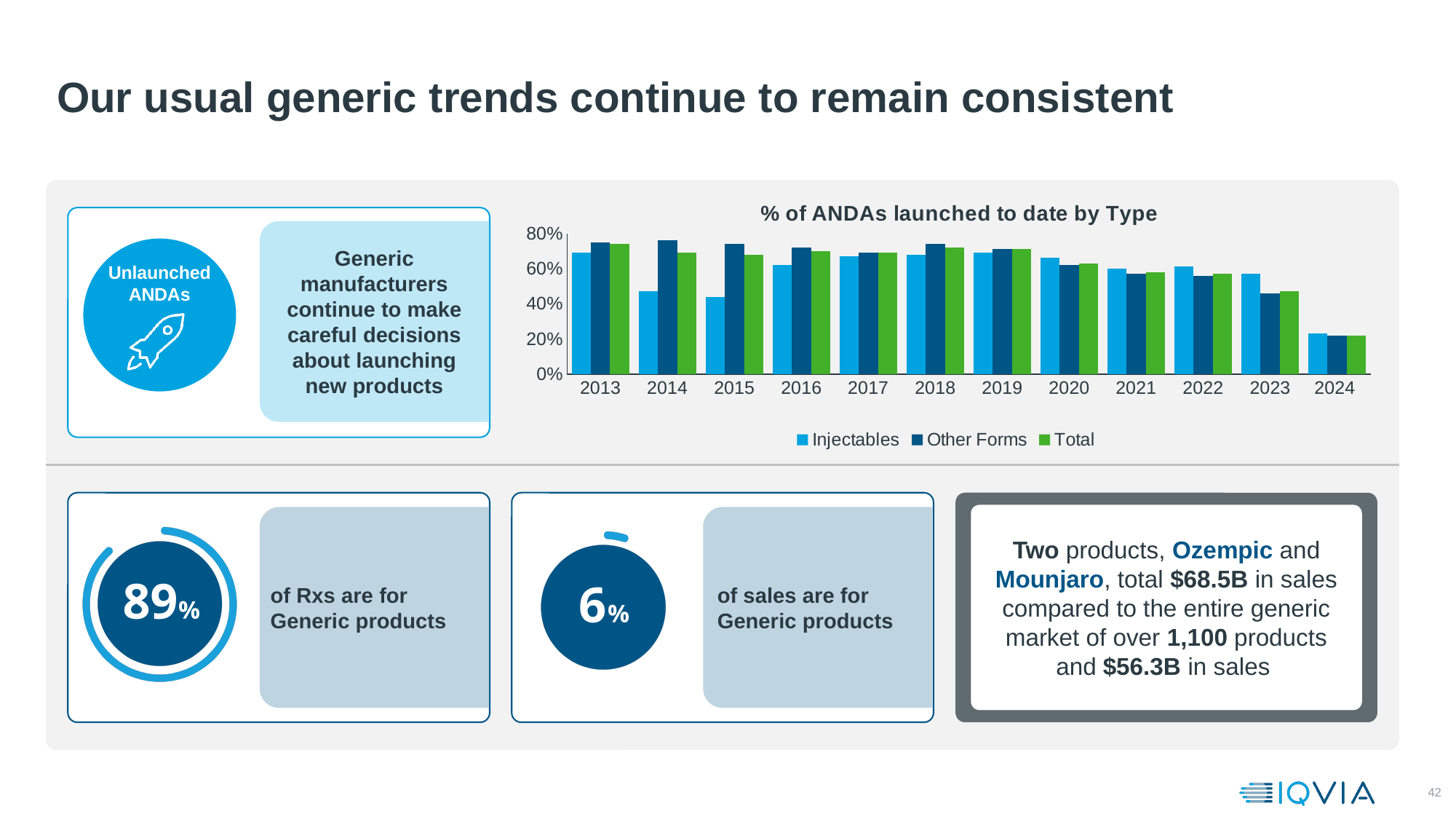
In the '% of ANDAs launched to date by Type' chart, is the Total value for 2024 greater or less than 40%? less In the '% of ANDAs launched to date by Type' chart, which is larger in 2014: Injectables or Other Forms? Other Forms In the '% of ANDAs launched to date by Type' chart, is the Other Forms value for 2013 greater or less than 60%? greater In the '% of ANDAs launched to date by Type' chart, is the Injectables value for 2014 greater or less than 60%? less In the '% of ANDAs launched to date by Type' chart, which year has the lowest Injectables value? 2024 What kind of chart is '% of ANDAs launched to date by Type'? bar chart How many years are shown on the x axis of the '% of ANDAs launched to date by Type' chart? 12 Which series in the '% of ANDAs launched to date by Type' chart is shown in green? Total How many series does the legend of the '% of ANDAs launched to date by Type' chart list? 3 In the '% of ANDAs launched to date by Type' chart, which year has the lowest Total value? 2024 In the '% of ANDAs launched to date by Type' chart, do the Total values generally rise or fall from 2019 to 2024? fall